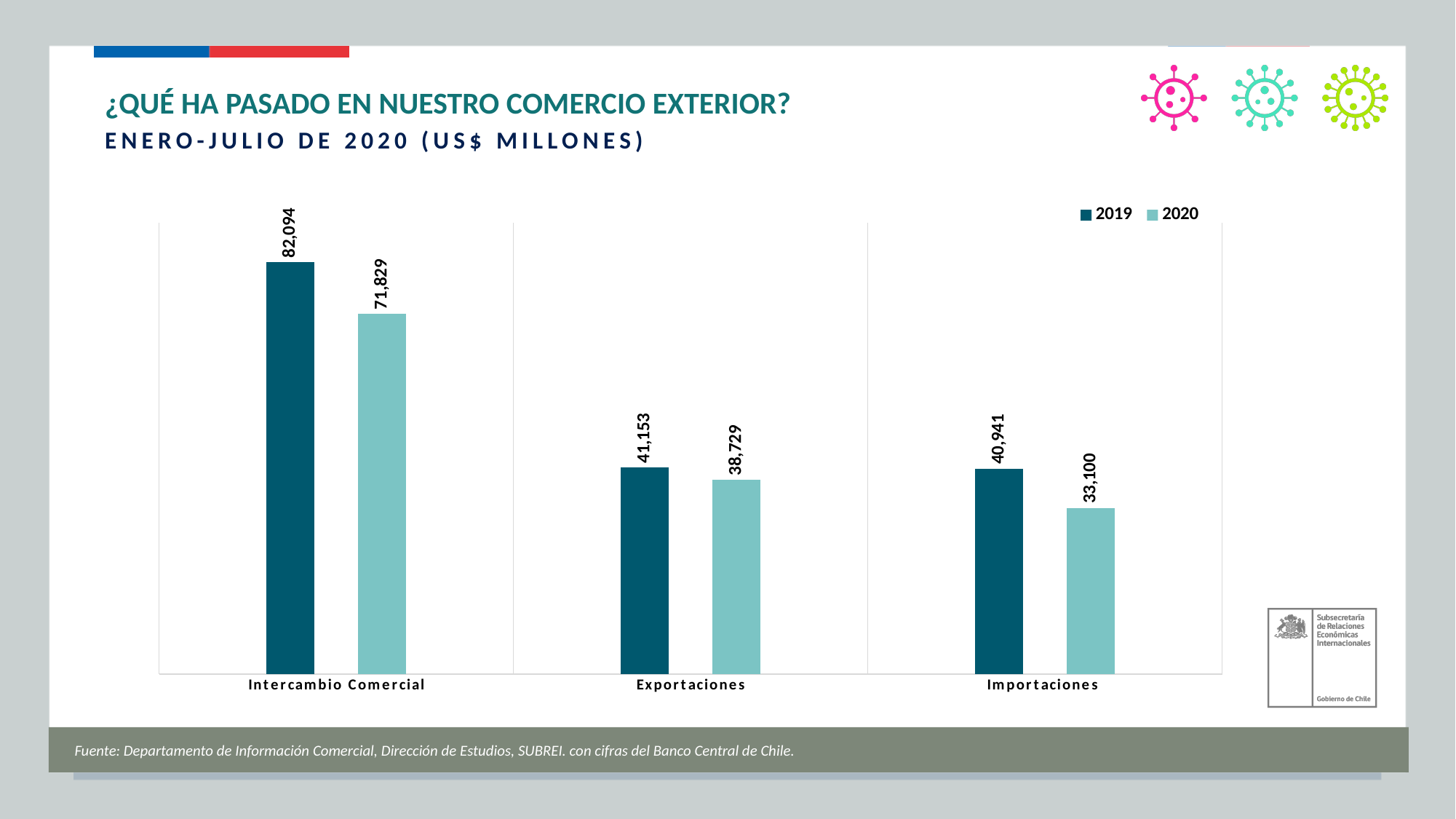
What is the difference between the 2019 and 2020 values for Intercambio Comercial? 10,265 What is the difference between the 2019 and 2020 values for Importaciones? 7,841 What is the 2019 value for Importaciones? 40,941 What is the 2020 value for Exportaciones? 38,729 What kind of chart is shown on the slide? Bar chart How many series does the legend list? 2 Which category has the lowest 2020 value? Importaciones What is the 2019 value for Intercambio Comercial? 82,094 What is the 2020 value for Importaciones? 33,100 How many categories are shown on the x axis? 3 Which is larger: the 2020 value for Exportaciones or the 2020 value for Importaciones? Exportaciones Which category has the highest 2020 value? Intercambio Comercial